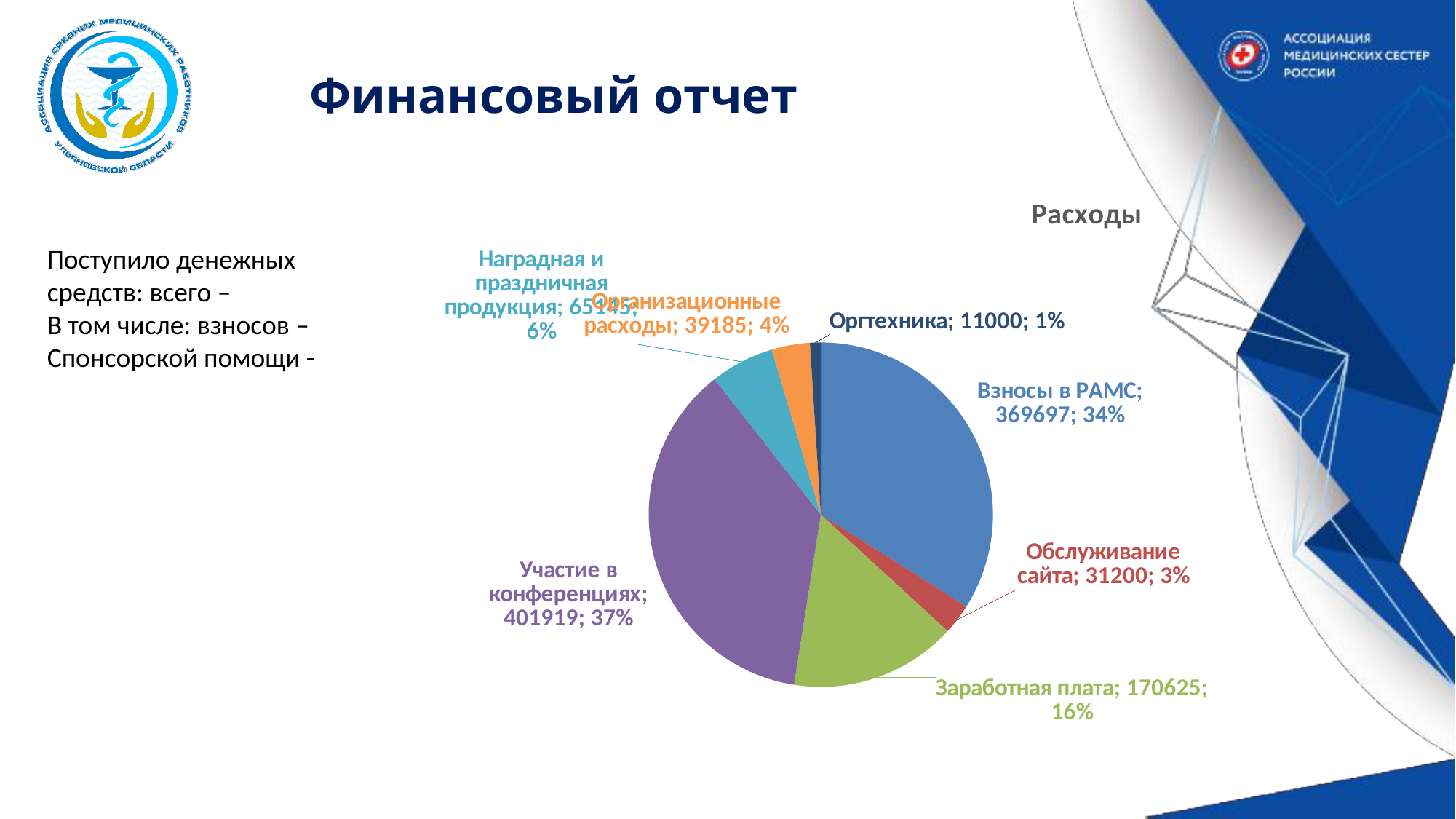
What is the value for Оргтехника? 11000 How many slices does the pie chart have? 7 What is the value for Участие в конференциях? 401919 What is the difference between the values for Участие в конференциях and Взносы в РАМС? 32222 What is the value for Взносы в РАМС? 369697 What is the value for Заработная плата? 170625 What kind of chart is shown on the slide? pie chart Which category has the largest slice of the pie? Участие в конференциях Which category has the smallest slice of the pie? Оргтехника What share of the pie does Взносы в РАМС represent? 34% Which is larger, the value for Заработная плата or the value for Обслуживание сайта? Заработная плата What is the title of the chart? Расходы